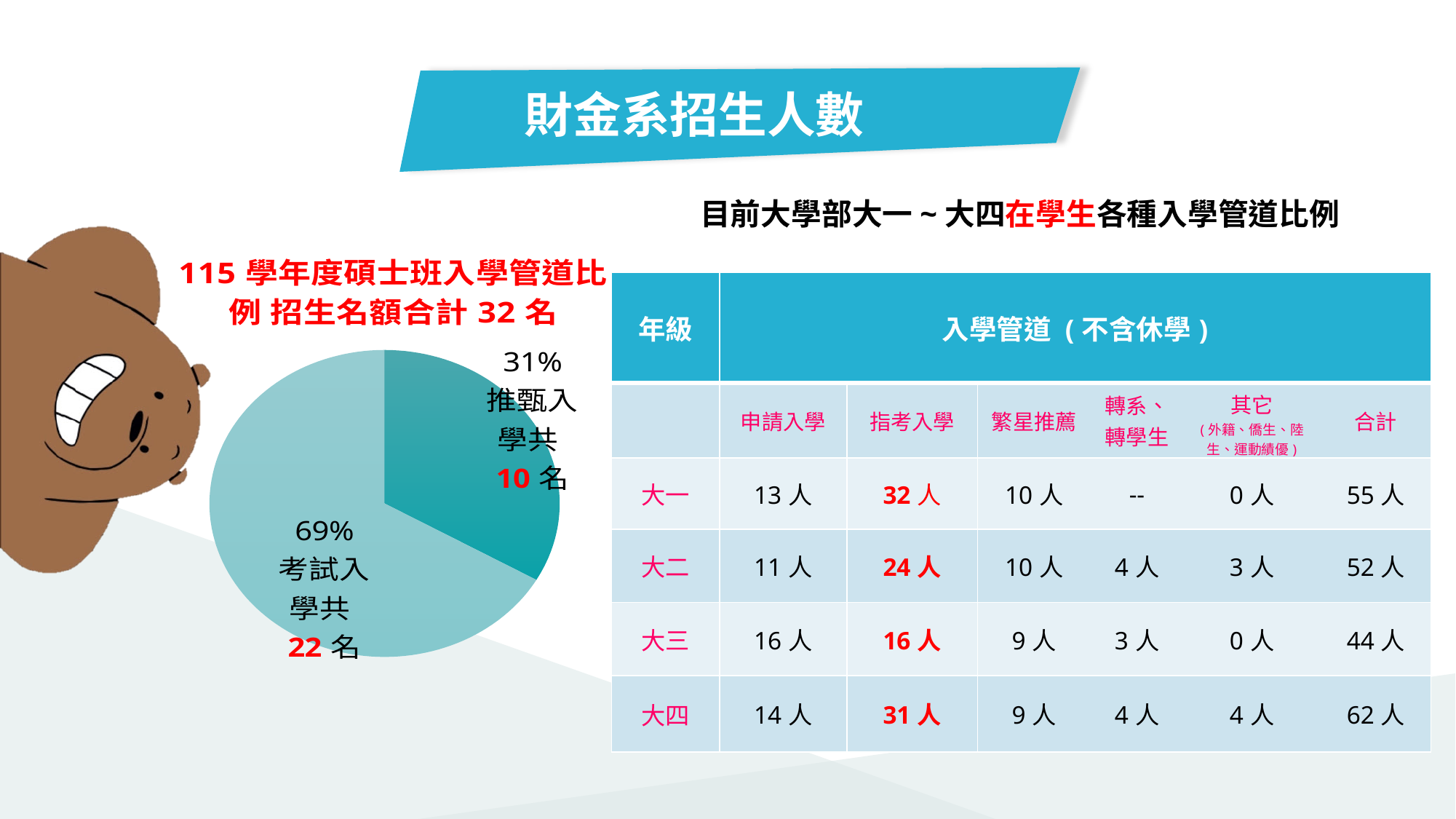
Which slice of the pie chart is the largest? 考試入學 In the pie chart, how many people (名) are shown for 推甄入學? 10 名 According to the pie chart's title, what is the total number of admission places (招生名額合計)? 32 名 What is the difference in people between 考試入學 (22 名) and 推甄入學 (10 名) in the pie chart? 12 名 In the pie chart, what share is labelled for 考試入學? 69% What kind of chart is shown on the left of the slide? pie chart In the pie chart, what share is labelled for 推甄入學? 31% Which academic year (學年度) does the pie chart's title refer to? 115 學年度 How many slices does the pie chart have? 2 In the pie chart, how many people (名) are shown for 考試入學? 22 名 In the pie chart, which is larger: 考試入學 or 推甄入學? 考試入學 Which slice of the pie chart is the smallest? 推甄入學